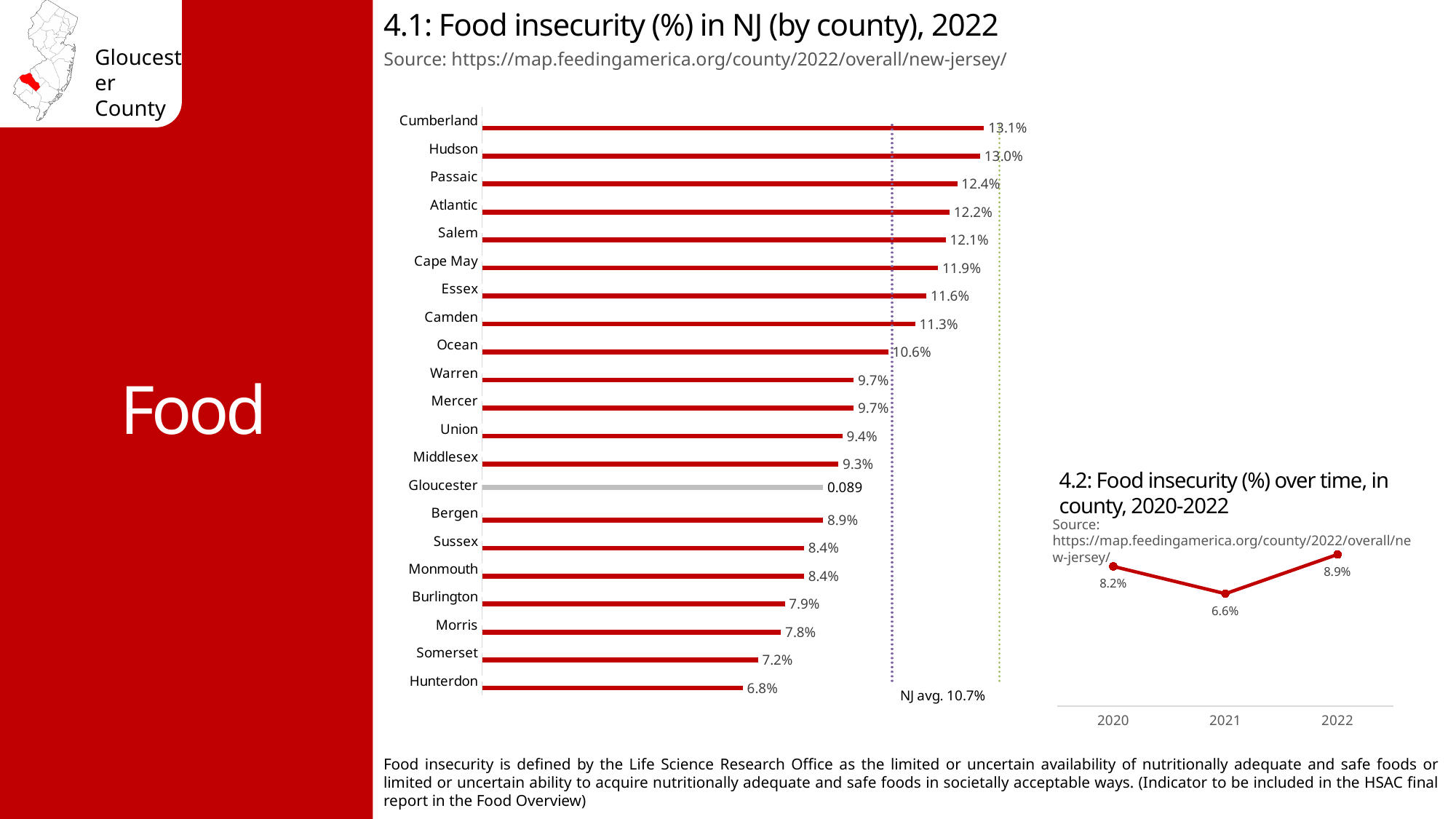
In chart 4.1 (Food insecurity in NJ by county, 2022), which county has the lowest value? Hunterdon In chart 4.2 (Food insecurity over time, 2020-2022), what is the value for 2021? 6.6% In chart 4.1 (Food insecurity in NJ by county, 2022), which county has the highest value? Cumberland In chart 4.1 (Food insecurity in NJ by county, 2022), what is the value for Cumberland? 13.1% In chart 4.1 (Food insecurity in NJ by county, 2022), what is the difference between the values for Passaic and Hunterdon? 5.6 percentage points In chart 4.1 (Food insecurity in NJ by county, 2022), what NJ average value is labelled on the chart? 10.7% In chart 4.1 (Food insecurity in NJ by county, 2022), which has the larger value, Essex or Camden? Essex In chart 4.1 (Food insecurity in NJ by county, 2022), what is the value for Hunterdon? 6.8% In chart 4.1 (Food insecurity in NJ by county, 2022), what label is printed next to the Gloucester bar? 0.089 In chart 4.2 (Food insecurity over time, 2020-2022), which year has the lowest value? 2021 In chart 4.1 (Food insecurity in NJ by county, 2022), how many counties are shown? 21 What kind of chart is chart 4.1 (Food insecurity in NJ by county, 2022)? Bar chart